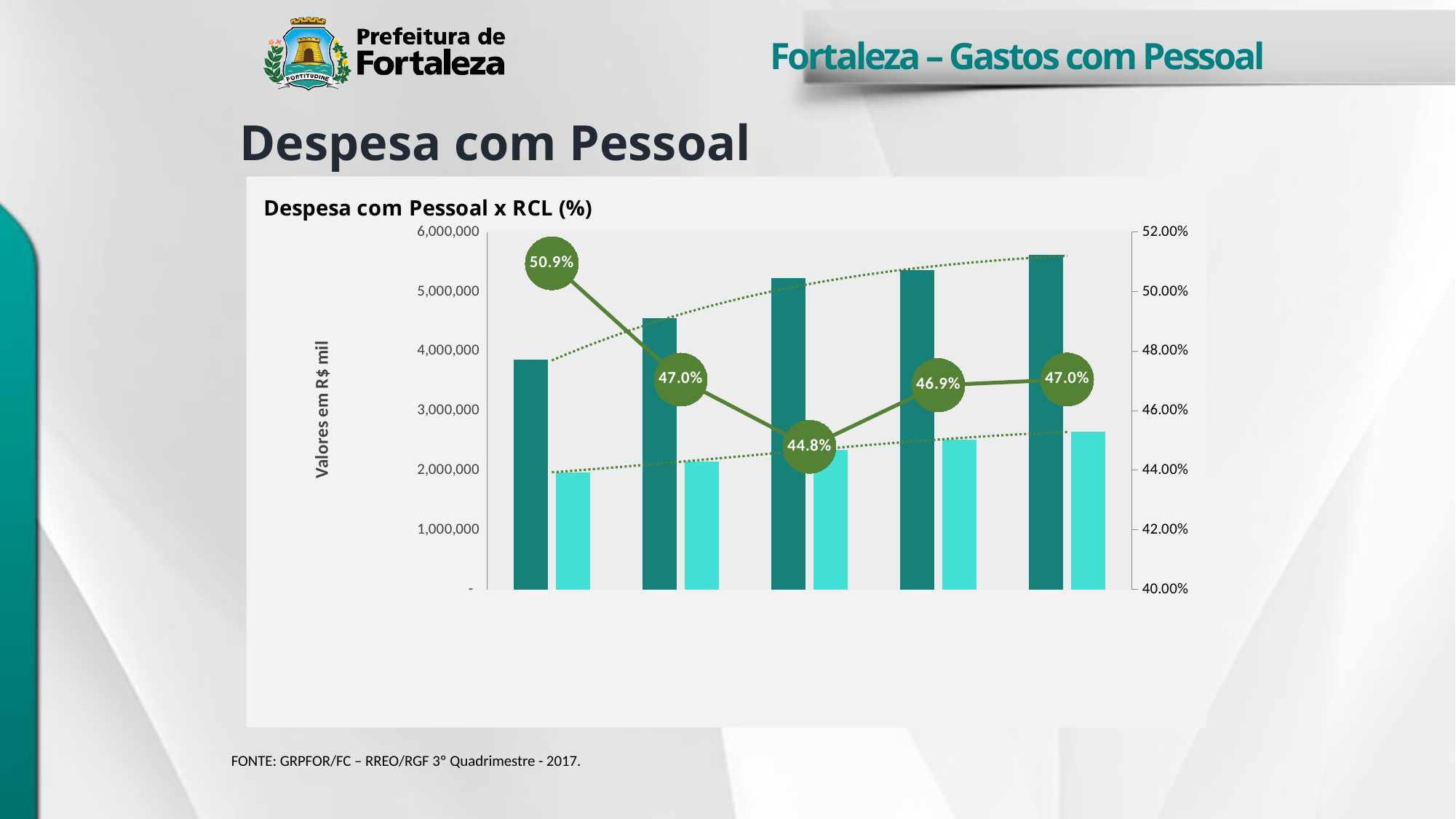
How many groups of bars are plotted in the chart? 5 Do the dark teal bars rise or fall from left to right? rise Which point of the line has the lowest labelled percentage? The third point, 44.8% What percentage is labelled on the first (leftmost) point of the line? 50.9% What is the title of the chart? Despesa com Pessoal x RCL (%) What is the label of the left vertical axis? Valores em R$ mil Is the value of the first (leftmost) dark teal bar greater or less than 4,000,000? less Is the value of the fifth (rightmost) dark teal bar greater or less than 5,000,000? greater What kind of chart is shown on the slide? Combined bar and line chart Which point of the line has the highest labelled percentage? The first (leftmost) point, 50.9% What is the difference between the highest and lowest labelled percentages on the line? 6.1 percentage points What percentage is labelled on the third point of the line? 44.8%